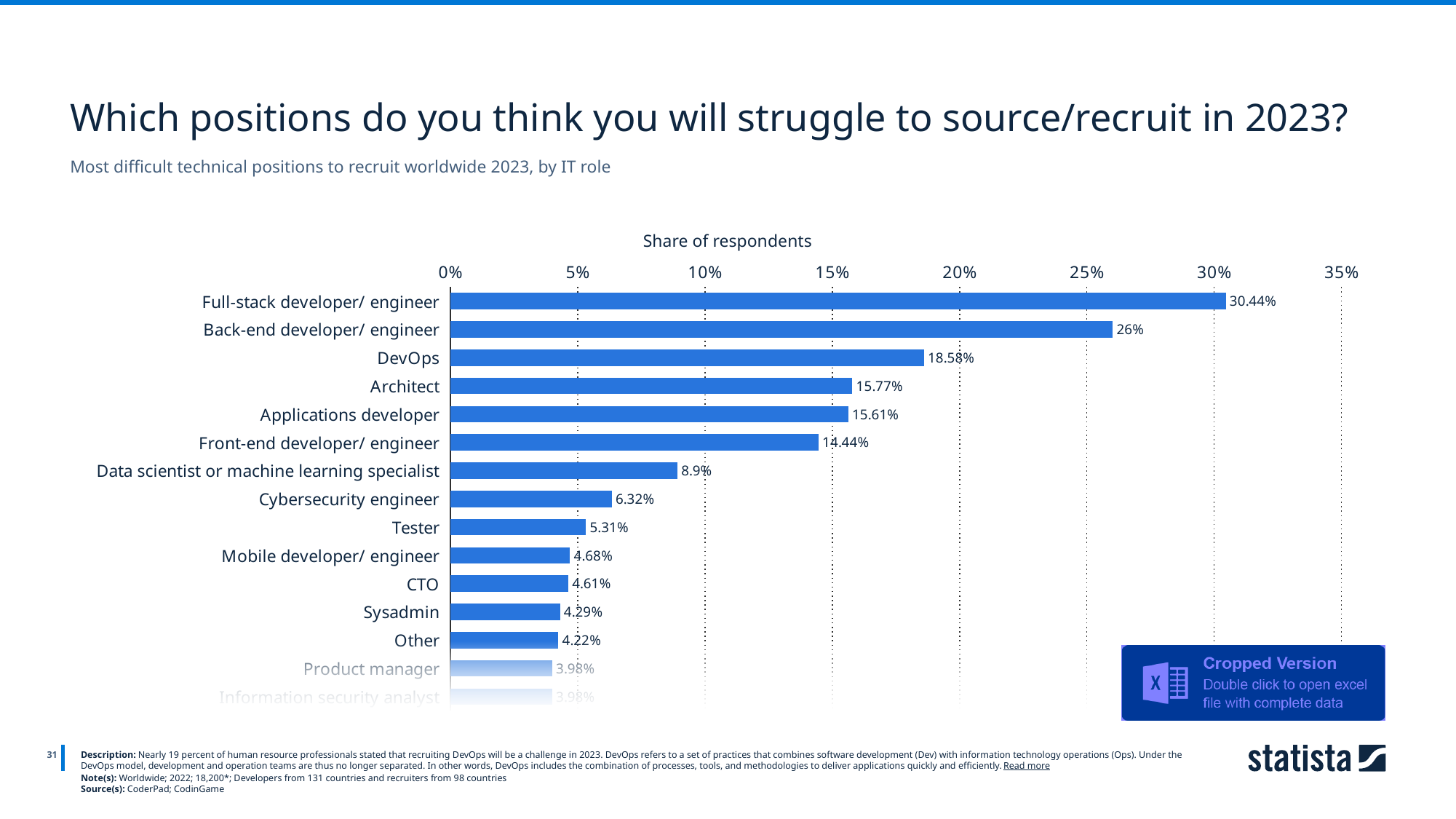
What share of respondents said they will struggle to recruit a Full-stack developer/ engineer? 30.44% Which has a larger value, DevOps or Front-end developer/ engineer? DevOps What is the difference between the values for Architect and Applications developer? 0.16% What is the axis title shown above the chart? Share of respondents Is the value for Back-end developer/ engineer greater or less than 25%? greater What kind of chart is shown on the slide? Bar chart What is the value shown for DevOps? 18.58% Which has a larger value, Tester or Mobile developer/ engineer? Tester What is the difference between the values for Full-stack developer/ engineer and Back-end developer/ engineer? 4.44% What share of respondents is shown for Cybersecurity engineer? 6.32% What is the value shown for Sysadmin? 4.29% Which position has the highest share of respondents? Full-stack developer/ engineer